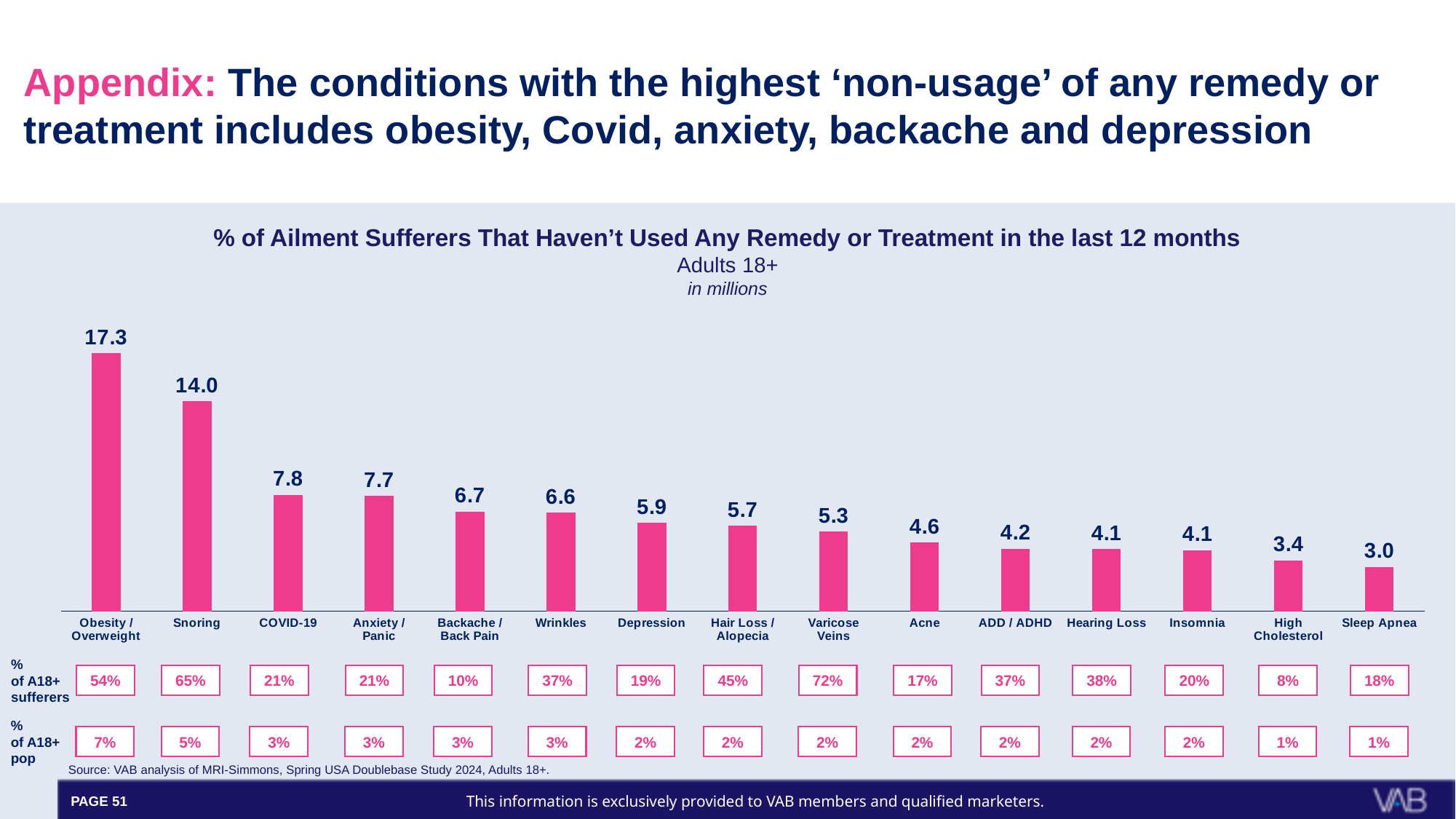
What is the difference between the values for Depression and Acne? 1.3 Which category has the lowest value? Sleep Apnea What is the value for Obesity / Overweight? 17.3 What is the value for High Cholesterol? 3.4 Which is larger, the value for Wrinkles or the value for Varicose Veins? Wrinkles Do the values rise or fall from left to right along the x axis? Fall Which category has the highest value? Obesity / Overweight What kind of chart is shown on the slide? Bar chart What is the title of the chart? % of Ailment Sufferers That Haven't Used Any Remedy or Treatment in the last 12 months How many categories are shown in the chart? 15 What is the value for Depression? 5.9 What is the difference between the values for Obesity / Overweight and Snoring? 3.3